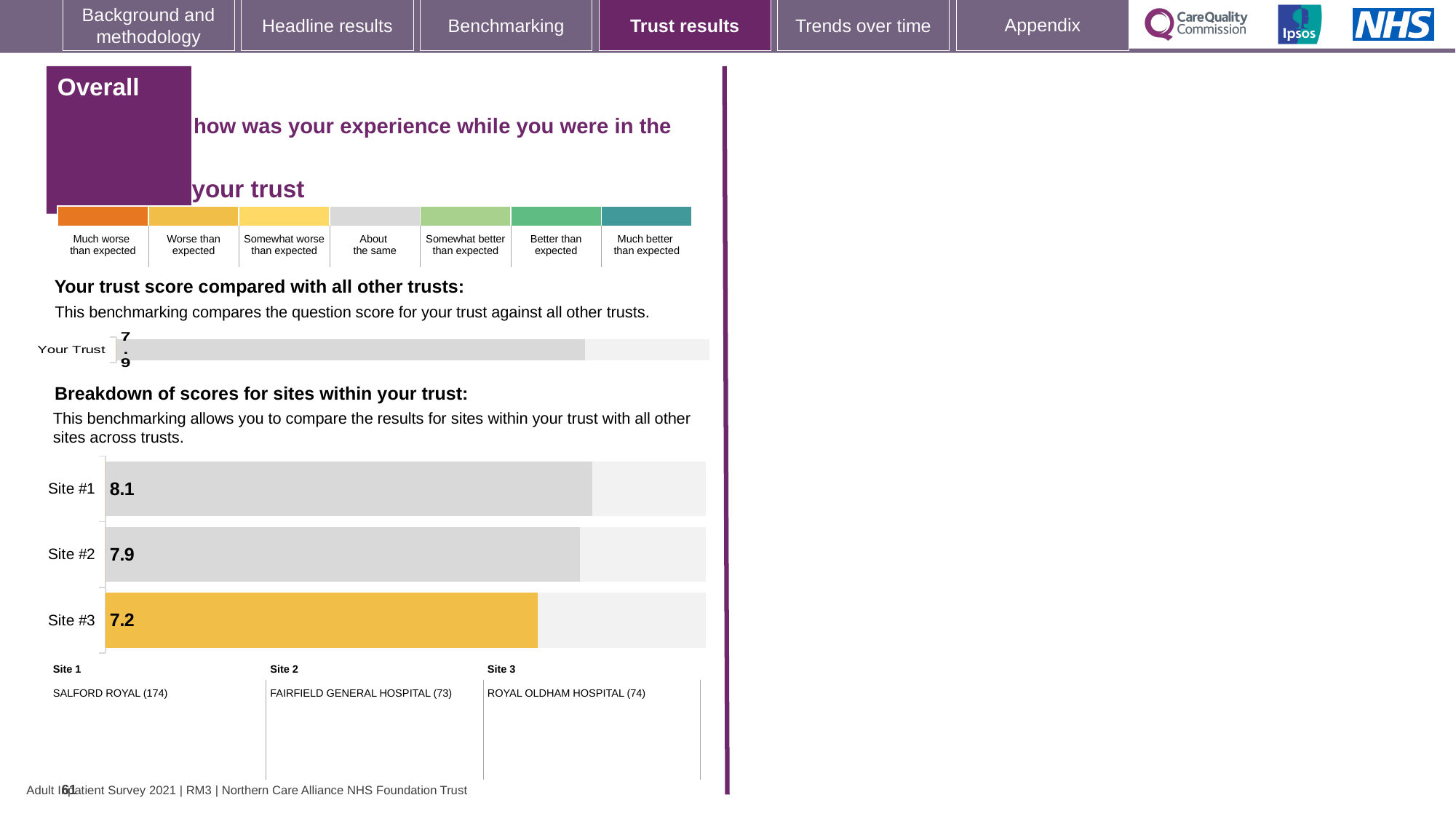
In the 'Breakdown of scores for sites within your trust' chart, which site's bar is coloured yellow rather than grey? Site #3 What kind of chart is the 'Breakdown of scores for sites within your trust' chart? Bar chart In the 'Breakdown of scores for sites within your trust' chart, do the scores rise or fall from Site #1 to Site #3? Fall In the 'Breakdown of scores for sites within your trust' chart, what is the difference between the scores for Site #1 and Site #3? 0.9 In the 'Your trust score compared with all other trusts' chart, what is the score for Your Trust? 7.9 How many sites are shown in the 'Breakdown of scores for sites within your trust' chart? 3 In the 'Breakdown of scores for sites within your trust' chart, what is the score for Site #3? 7.2 In the 'Breakdown of scores for sites within your trust' chart, what is the score for Site #1? 8.1 In the 'Breakdown of scores for sites within your trust' chart, which has the larger score, Site #2 or Site #3? Site #2 In the 'Breakdown of scores for sites within your trust' chart, which site has the highest score? Site #1 In the 'Breakdown of scores for sites within your trust' chart, which site has the lowest score? Site #3 In the 'Breakdown of scores for sites within your trust' chart, what is the score for Site #2? 7.9